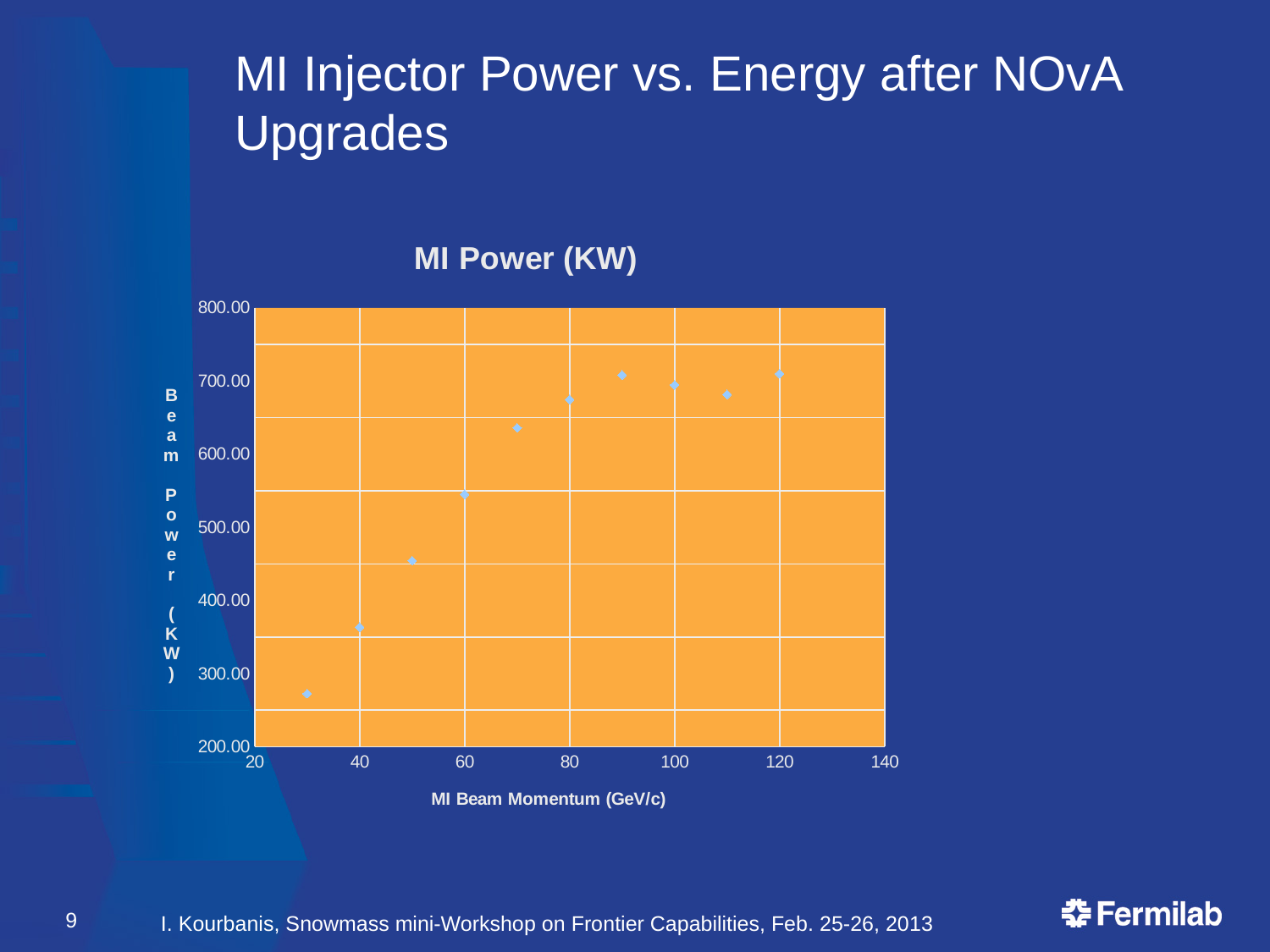
How many data points are plotted on the chart? 10 At which beam momentum is the plotted power lowest? 30 What is the title of the chart? MI Power (KW) Is the value at 50 GeV/c greater or less than 500? less Do the plotted power values generally rise or fall as beam momentum increases from 30 to 90 GeV/c? rise What is the label of the x axis? MI Beam Momentum (GeV/c) Which has the larger power value, 60 GeV/c or 80 GeV/c? 80 Is the value at 70 GeV/c greater or less than 600? greater Is the value at 60 GeV/c greater or less than 500? greater What kind of chart is shown on the slide? scatter chart